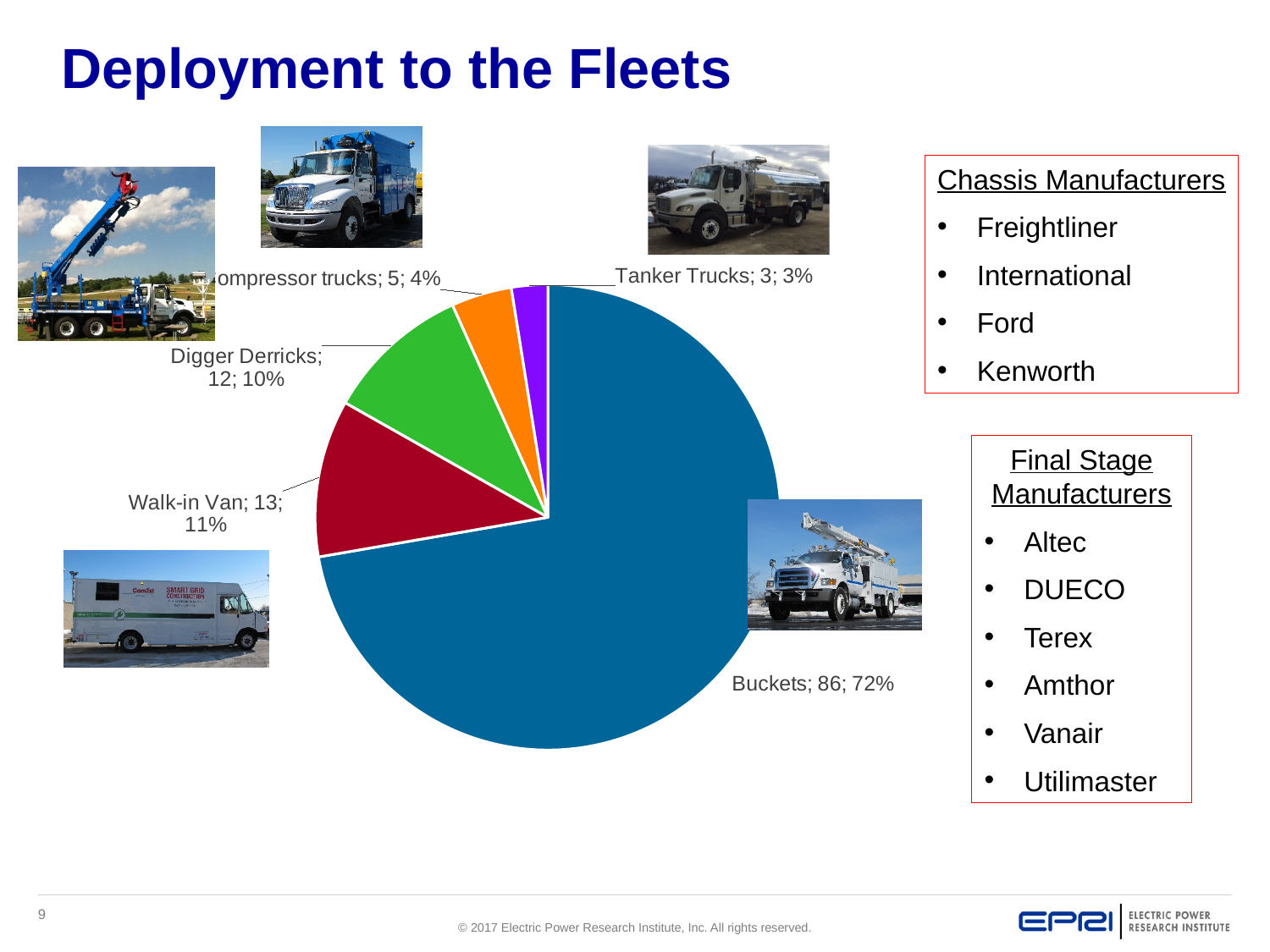
What share of the pie do Buckets represent? 72% What is the difference in count between Buckets and Walk-in Van? 73 Which category has the smallest slice of the pie chart? Tanker Trucks What is the count for Tanker Trucks in the pie chart? 3 What percentage of the pie is Digger Derricks? 10% What is the count for Walk-in Van in the pie chart? 13 Which category has the largest slice of the pie chart? Buckets What is the total count across all slices of the pie chart? 119 How many slices does the pie chart have? 5 What kind of chart is shown on the slide? pie chart Which has a larger count, Digger Derricks or Tanker Trucks? Digger Derricks What is the count for Buckets in the pie chart? 86